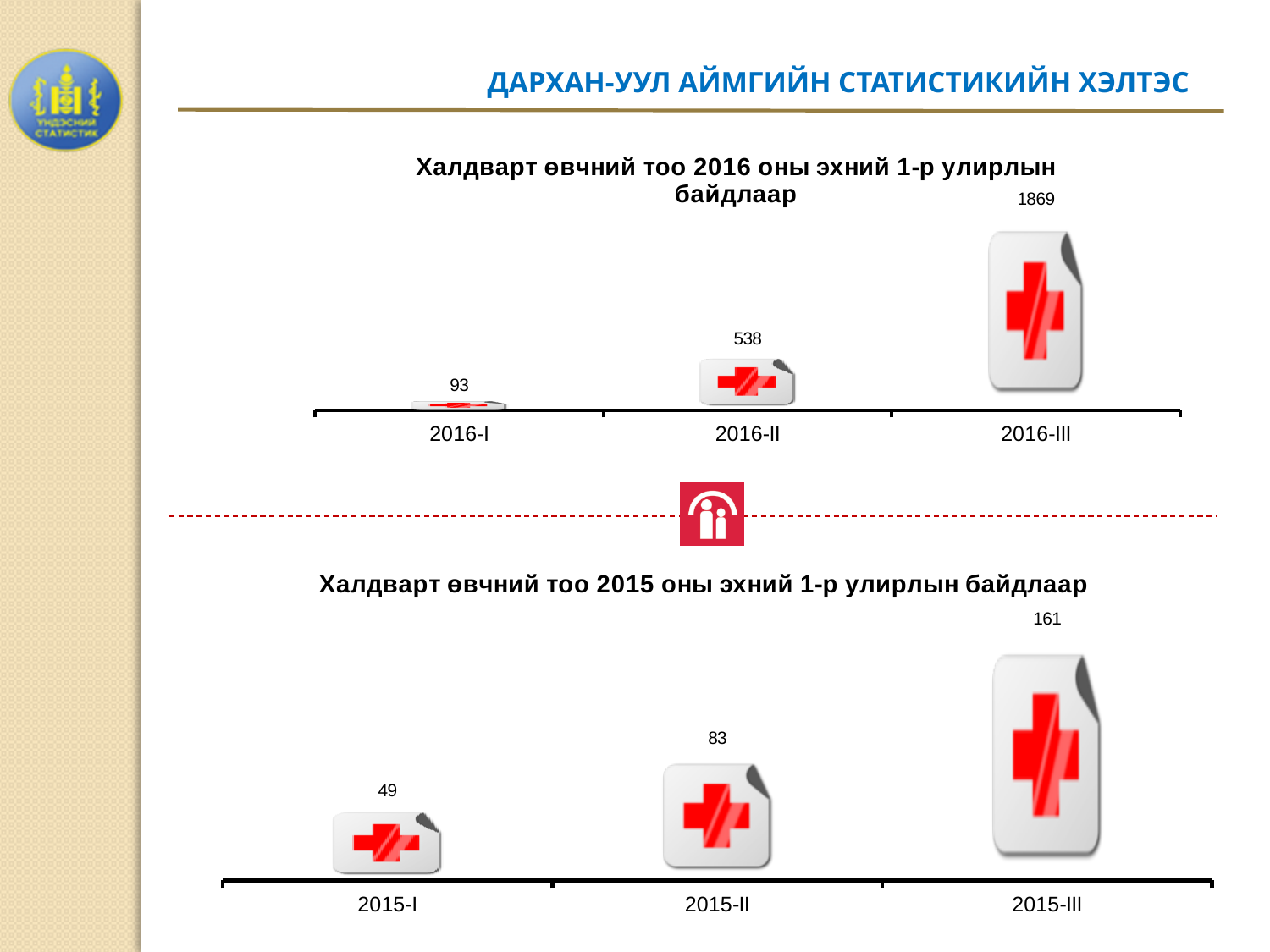
What kind of chart is the top chart (2016)? bar chart In the top chart (2016), what is the value for 2016-II? 538 In the top chart (2016), what is the value for 2016-III? 1869 In the top chart (2016), which category has the highest value? 2016-III In the bottom chart (2015), what is the difference between the values for 2015-II and 2015-I? 34 In the bottom chart (2015), which category has the lowest value? 2015-I How many categories are shown in the top chart (2016)? 3 In the bottom chart (2015), what is the value for 2015-I? 49 In the bottom chart (2015), which is larger, the value for 2015-II or 2015-III? 2015-III In the top chart (2016), what is the difference between the values for 2016-III and 2016-II? 1331 Do the values in the bottom chart (2015) rise or fall from 2015-I to 2015-III? rise In the bottom chart (2015), what is the value for 2015-III? 161